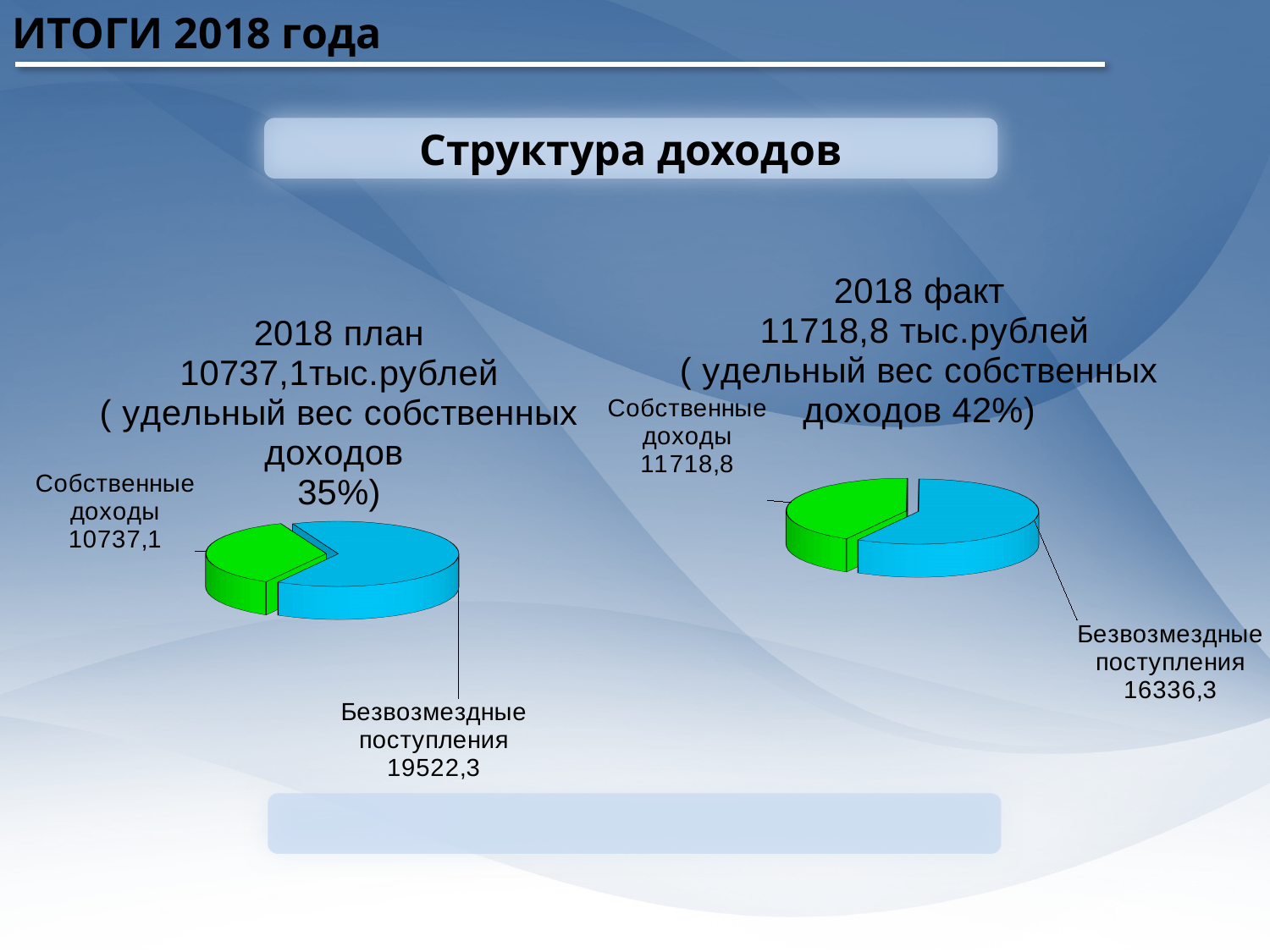
In the right pie chart (2018 факт), what is the value for Безвозмездные поступления? 16336,3 In the left pie chart (2018 план), what is the difference between Безвозмездные поступления and Собственные доходы? 8785,2 In the right pie chart (2018 факт), what is the difference between Безвозмездные поступления and Собственные доходы? 4617,5 According to the title of the right chart (2018 факт), what share of income do Собственные доходы make up? 42% In the left pie chart (2018 план), which category has the largest slice? Безвозмездные поступления In the right pie chart (2018 факт), what is the value for Собственные доходы? 11718,8 According to the title of the left chart (2018 план), what share of income do Собственные доходы make up? 35% In the left pie chart (2018 план), what is the value for Безвозмездные поступления? 19522,3 Is the value for Собственные доходы larger in the left chart (2018 план) or in the right chart (2018 факт)? 2018 факт What type of chart is used for the 2018 план data? Pie chart In the right pie chart (2018 факт), which category has the smallest slice? Собственные доходы In the left pie chart (2018 план), what is the value for Собственные доходы? 10737,1